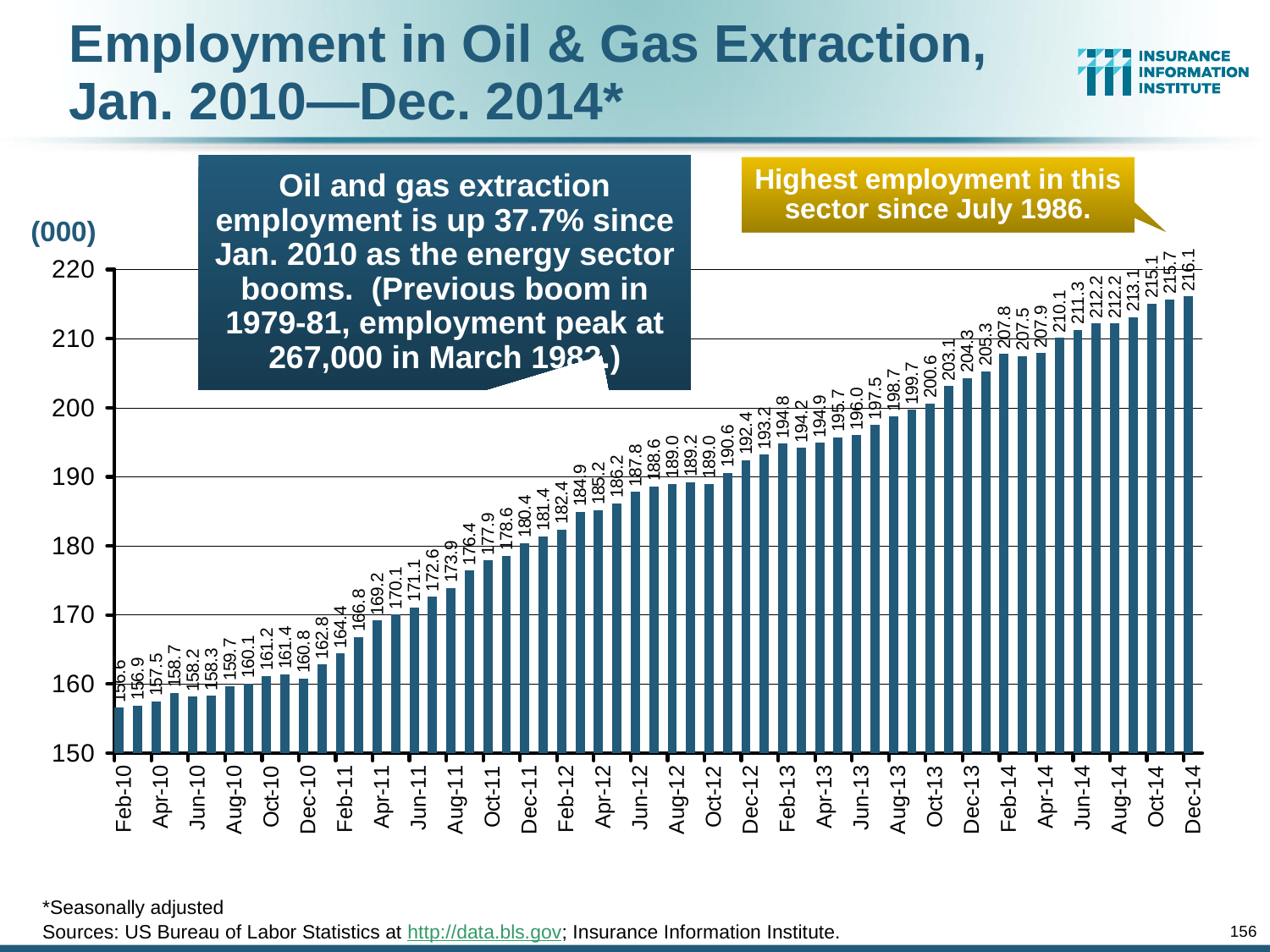
What is the employment value (in thousands) for Dec-14? 216.1 Do the values generally rise or fall from left to right along the x axis? rise What is the highest value shown on the chart? 216.1 Is the value for Feb-10 greater or less than 160? less Is the value for Dec-14 larger or smaller than the value for Feb-10? larger What is the last month shown on the x axis? Dec-14 What is the lowest value shown on the vertical axis? 150 Is the value for Dec-14 greater or less than 210? greater What type of chart is shown on the slide? bar chart What unit label is shown above the vertical axis? (000) Which month has the highest employment value on the chart? Dec-14 What is the first month label shown on the x axis? Feb-10